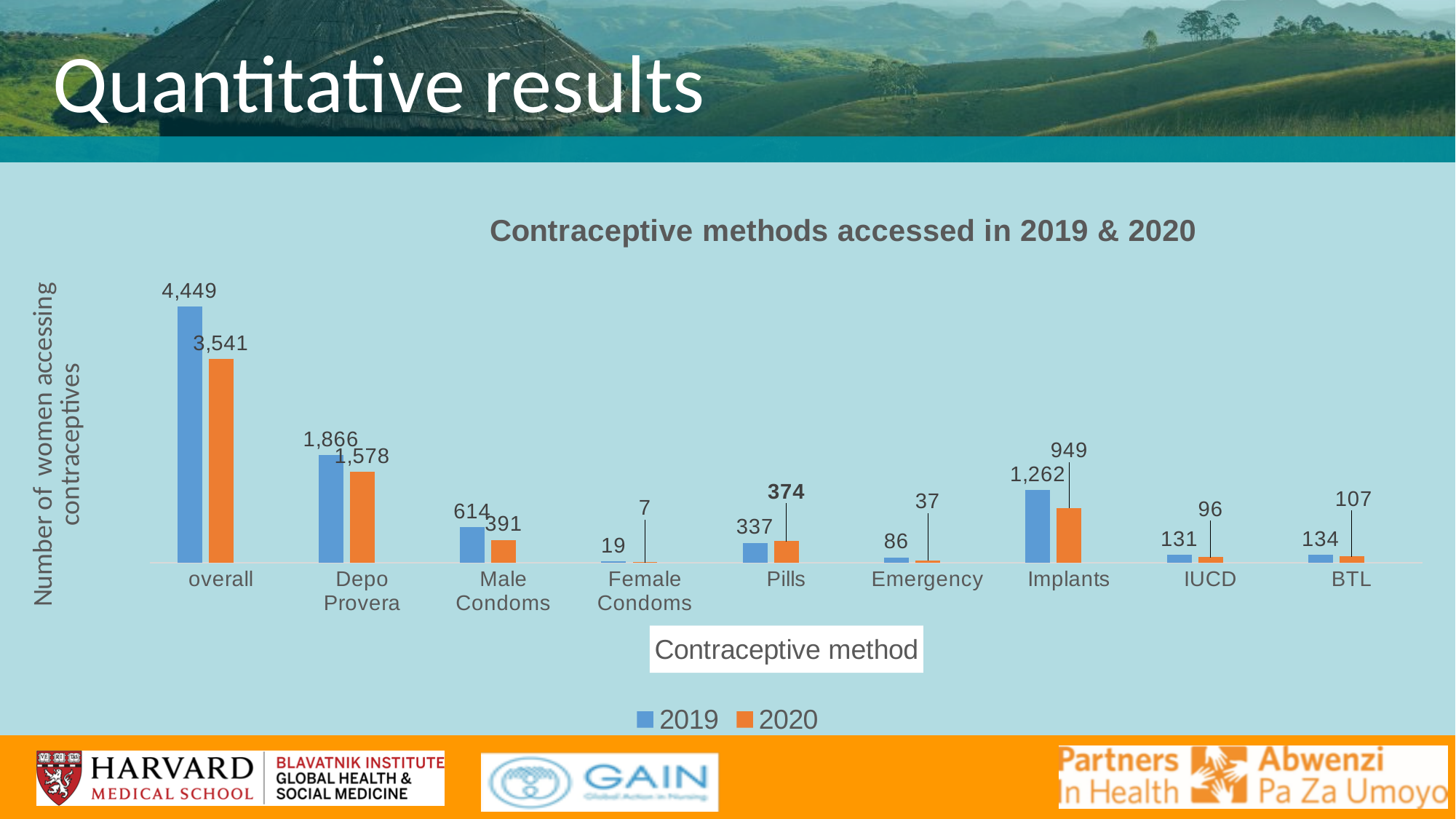
How many contraceptive method categories are shown on the x axis? 9 What is the title of the chart? Contraceptive methods accessed in 2019 & 2020 Which contraceptive method has the lowest 2020 value? Female Condoms Which is larger for Pills: the 2019 value or the 2020 value? 2020 What is the 2020 value for Depo Provera? 1,578 What kind of chart is shown on the slide? Bar chart How many series does the legend list? 2 What is the 2020 value for Implants? 949 What is the difference between the 2019 and 2020 values for Male Condoms? 223 What is the 2019 value for overall? 4,449 What is the 2019 value for Female Condoms? 19 Excluding the overall category, which contraceptive method has the highest 2019 value? Depo Provera